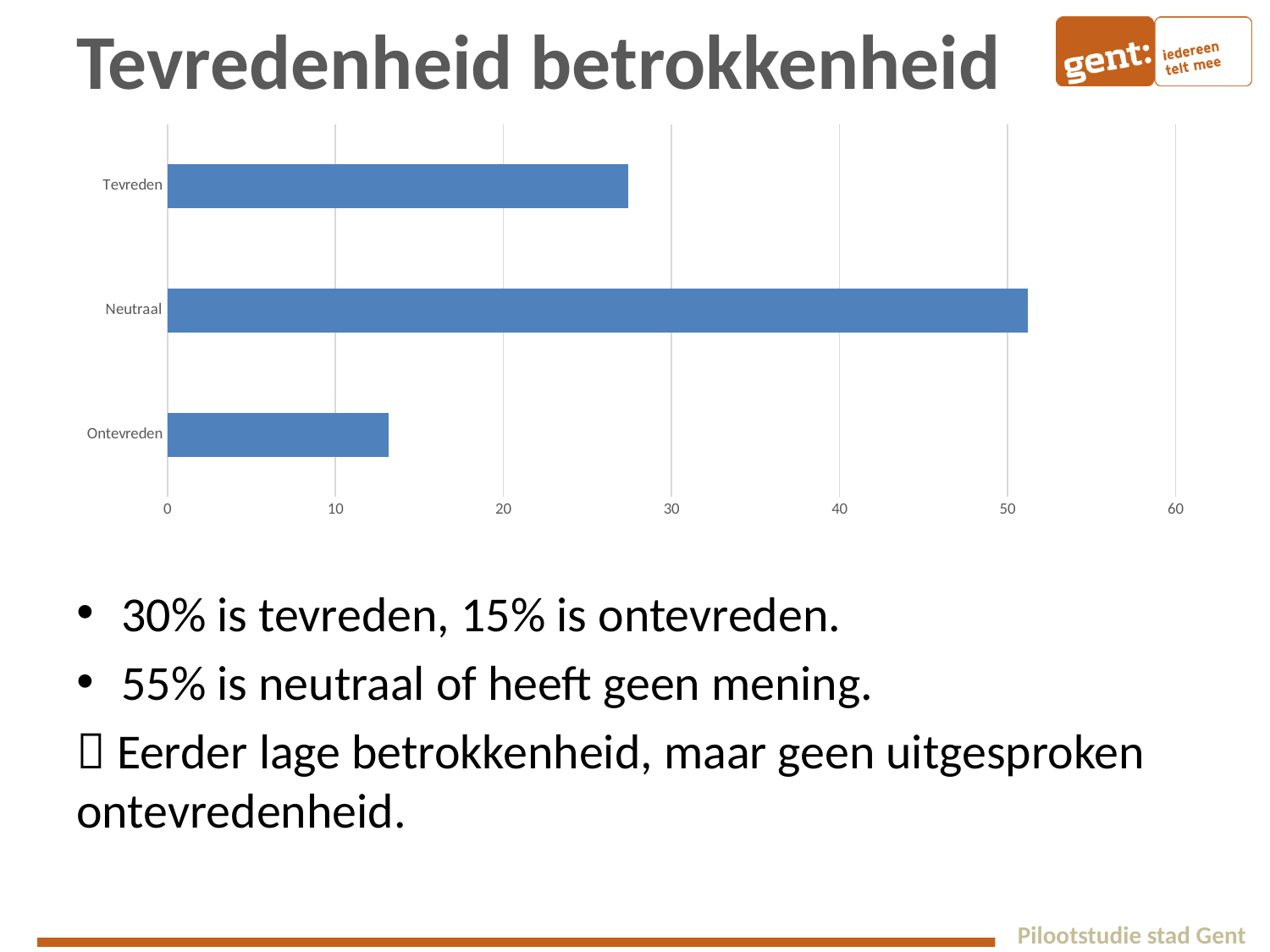
Is the value for Tevreden greater or less than 30? less What is the title of the slide containing the chart? Tevredenheid betrokkenheid What is the highest tick value shown on the horizontal axis of the chart? 60 How many categories does the bar chart show? 3 Is the value for Neutraal greater or less than 50? greater Which category has the lowest value in the bar chart? Ontevreden Is the value for Ontevreden greater or less than 10? greater What kind of chart is shown on the slide? bar chart Which is larger, the value for Tevreden or the value for Ontevreden? Tevreden Which category has the highest value in the bar chart? Neutraal Which is larger, the value for Neutraal or the value for Tevreden? Neutraal